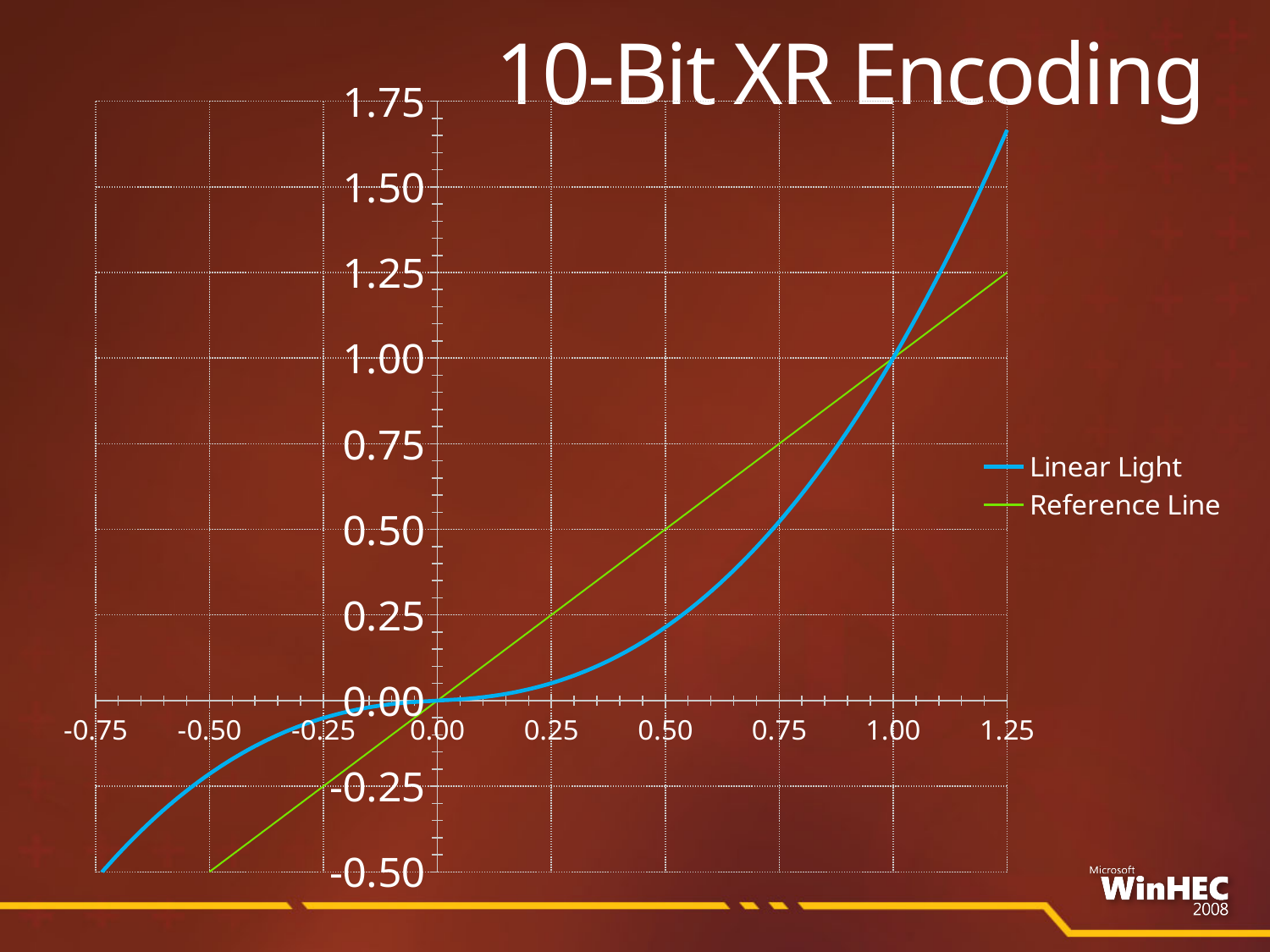
Does the Linear Light series rise or fall as x increases? rise Is the value of the Linear Light series at x = 1.25 greater or less than 1.50? greater At x = 1.25, which series has the higher value, Linear Light or Reference Line? Linear Light Which series is drawn in green? Reference Line What is the title of the chart? 10-Bit XR Encoding Is the value of the Linear Light series at x = 0.50 greater or less than 0.25? less How many series does the legend list? 2 What is the value of the Linear Light series at x = 0.00? 0.00 What kind of chart is shown on the slide? line chart What is the value of the Reference Line at x = 1.00? 1.00 What is the value of the Reference Line at x = 1.25? 1.25 At x = 0.50, which series has the higher value, Linear Light or Reference Line? Reference Line